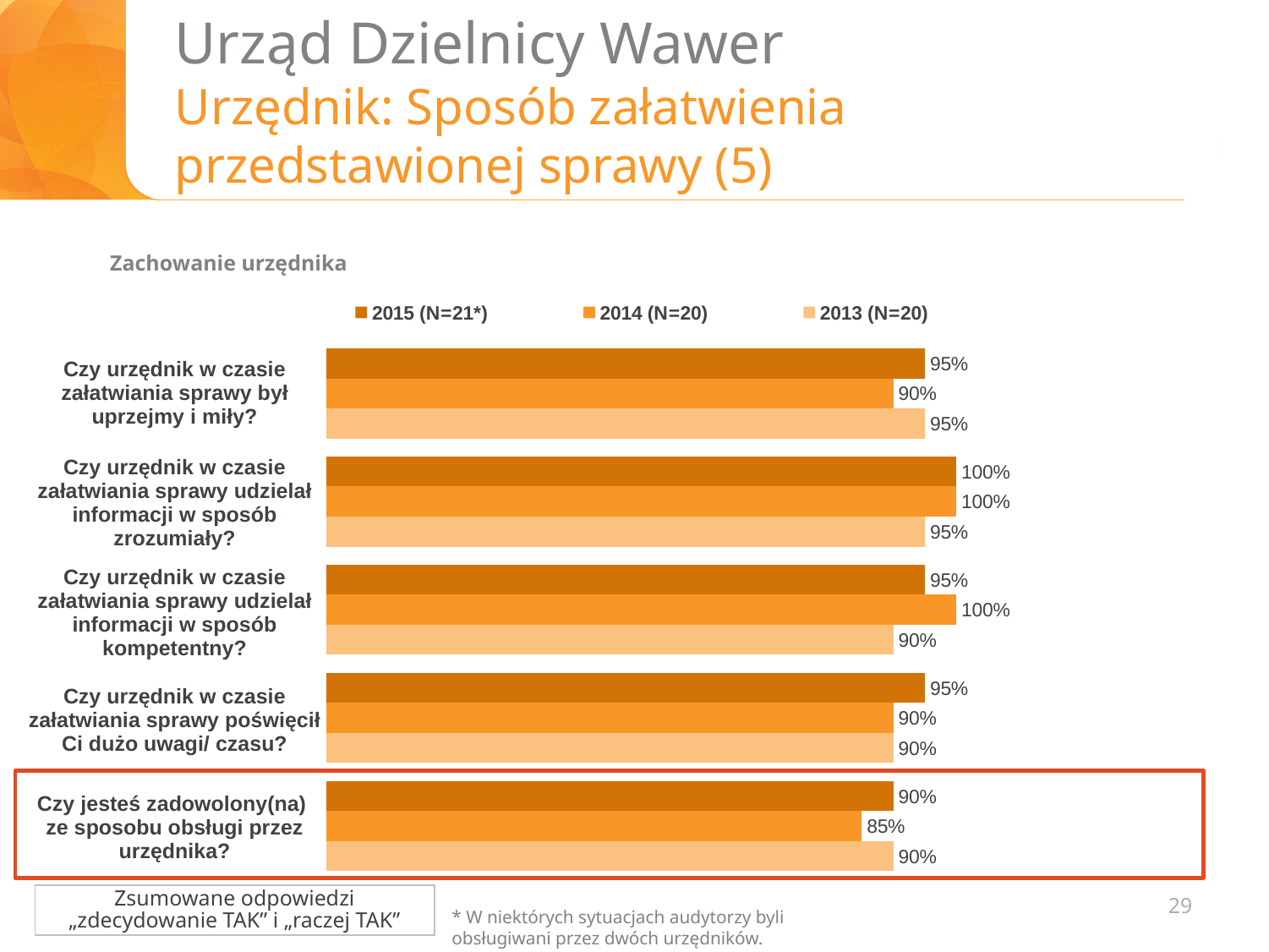
What is the difference between the 2014 (N=20) and 2013 (N=20) values for "Czy urzędnik w czasie załatwiania sprawy udzielał informacji w sposób kompetentny?"? 10% What is the 2015 (N=21*) value for "Czy urzędnik w czasie załatwiania sprawy był uprzejmy i miły?"? 95% Which category has the lowest 2015 (N=21*) value? Czy jesteś zadowolony(na) ze sposobu obsługi przez urzędnika? What type of chart is shown on the slide? bar chart How many question categories are plotted on the chart? 5 What is the 2013 (N=20) value for "Czy urzędnik w czasie załatwiania sprawy udzielał informacji w sposób kompetentny?"? 90% For "Czy urzędnik w czasie załatwiania sprawy był uprzejmy i miły?", which is larger: the 2015 (N=21*) value or the 2014 (N=20) value? 2015 (N=21*) Which category has the lowest 2014 (N=20) value? Czy jesteś zadowolony(na) ze sposobu obsługi przez urzędnika? How many series does the legend list? 3 What is the 2014 (N=20) value for "Czy jesteś zadowolony(na) ze sposobu obsługi przez urzędnika?"? 85% What is the title shown above the chart? Zachowanie urzędnika What is the difference between the 2015 (N=21*) and 2014 (N=20) values for "Czy jesteś zadowolony(na) ze sposobu obsługi przez urzędnika?"? 5%